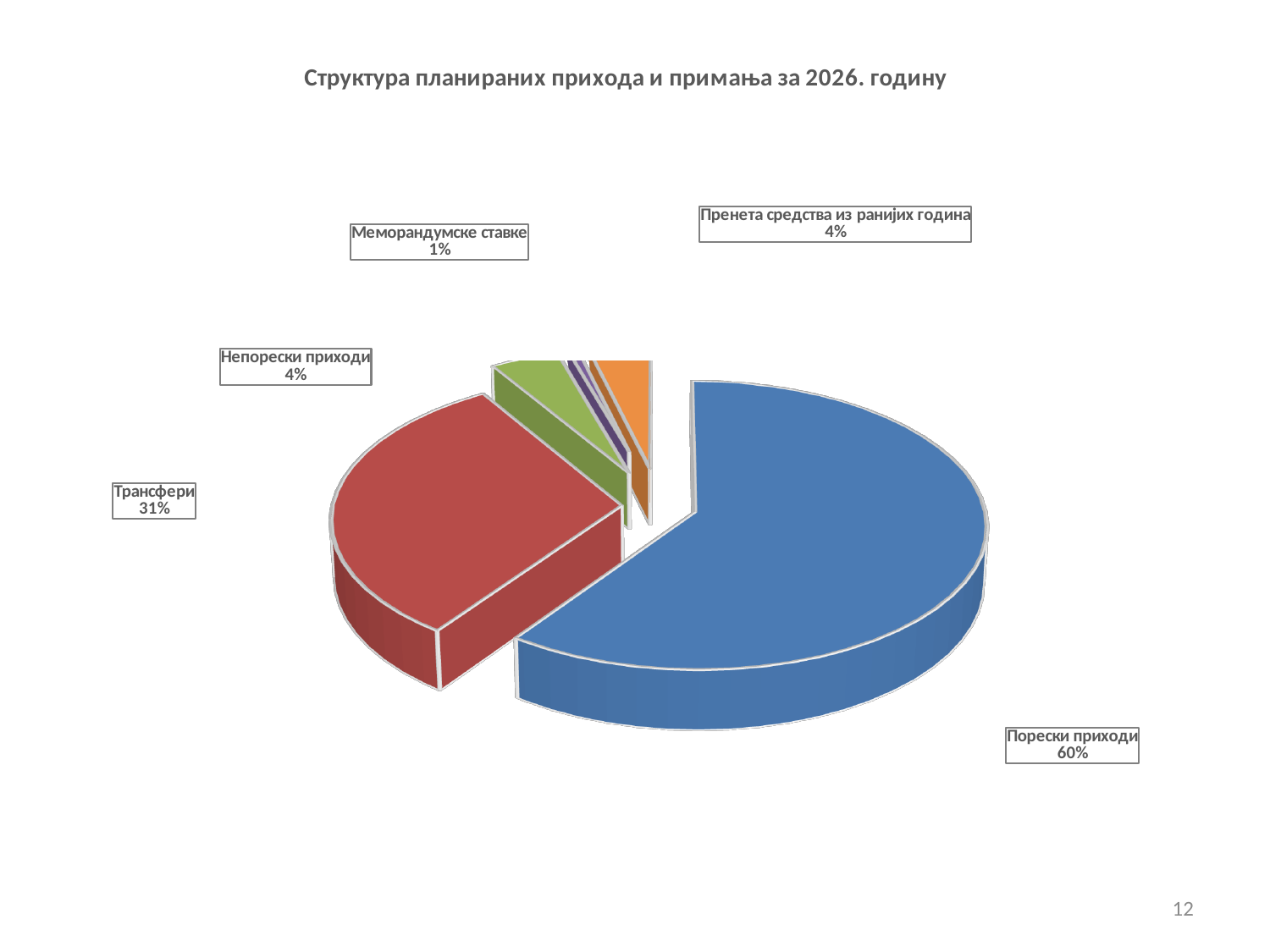
What is the difference in percentage points between Порески приходи and Трансфери? 29 What type of chart is shown on the slide? Pie chart Which is larger, the share for Трансфери or the share for Непорески приходи? Трансфери Which category has the smallest share of the pie? Меморандумске ставке What share of the pie is Порески приходи? 60% What share of the pie is Пренета средства из ранијих година? 4% What share of the pie is Меморандумске ставке? 1% How many slices does the pie chart have? 5 What is the title of the chart? Структура планираних прихода и примања за 2026. годину Which category has the largest share of the pie? Порески приходи